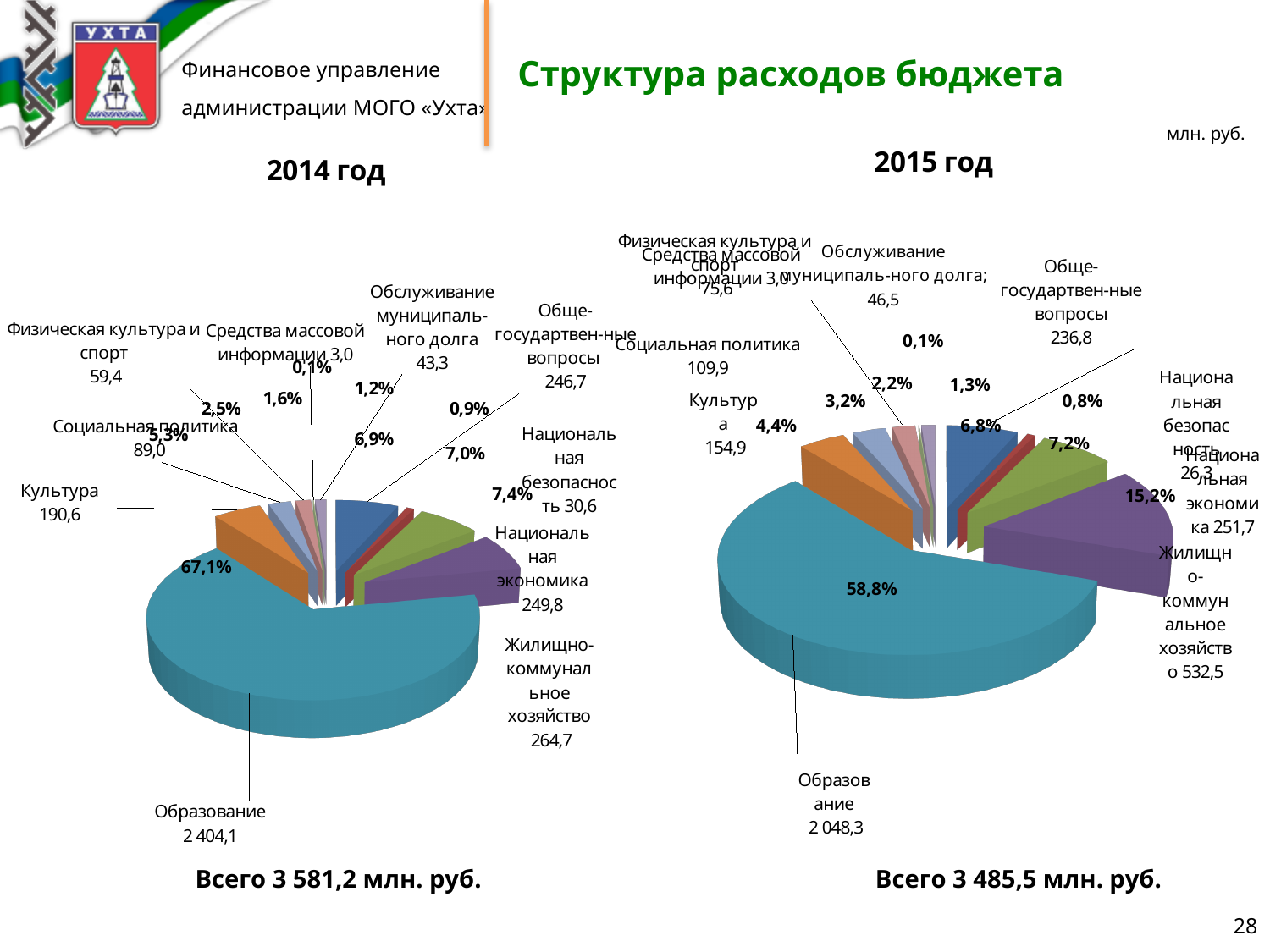
What type of chart is used on this slide? Pie chart On the 2014 год chart, which category has the largest slice? Образование On the 2015 год chart, what share of the pie does Образование take? 58,8% On the 2014 год chart, what is the value for Образование? 2 404,1 On the 2015 год chart, what is the value for Жилищно-коммунальное хозяйство? 532,5 On the 2015 год chart, which is larger: Национальная экономика or Общегосударственные вопросы? Национальная экономика What is the title of the slide? Структура расходов бюджета On the 2015 год chart, which category has the smallest slice? Средства массовой информации On the 2014 год chart, what share of the pie does Культура take? 5,3% What is the difference between the Образование values on the 2014 год and 2015 год charts? 355,8 How many categories are shown on the 2015 год chart? 10 What is the total shown under the 2014 год chart? 3 581,2 млн. руб.